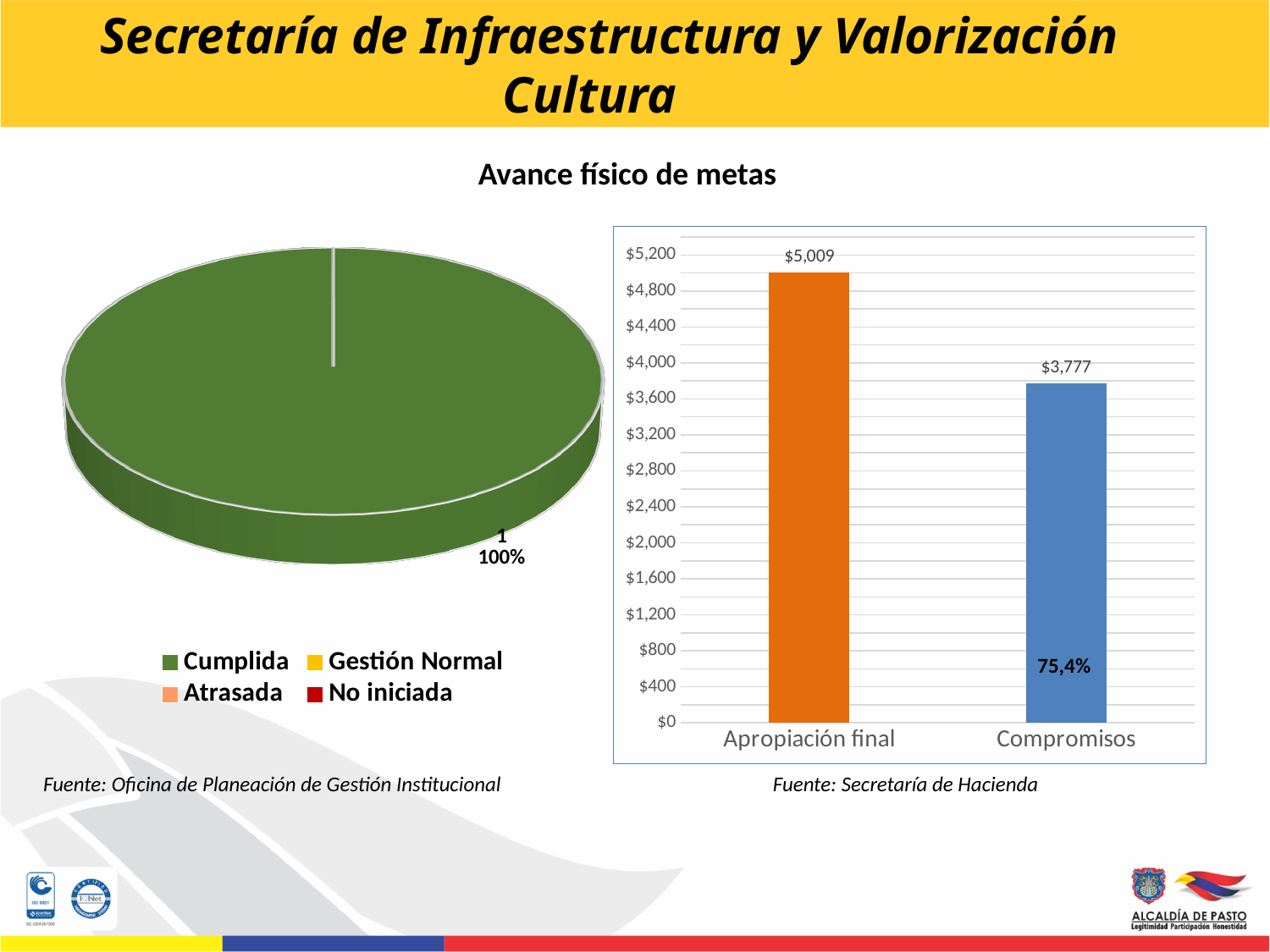
On the bar chart on the right, which category has the higher value? Apropiación final How many entries does the legend of the pie chart on the left list? 4 On the pie chart on the left, what share does the Cumplida slice represent? 100% On the bar chart on the right, which category has the lower value? Compromisos What kind of chart is shown on the right side of the slide? bar chart On the bar chart on the right, how many categories are shown on the x axis? 2 What kind of chart is shown on the left side of the slide? pie chart On the bar chart on the right, what is the value for Compromisos? $3,777 On the bar chart on the right, what percentage label is printed on the Compromisos bar? 75,4% On the bar chart on the right, what is the difference between Apropiación final and Compromisos? $1,232 On the bar chart on the right, is the value for Compromisos greater or less than $4,000? less On the bar chart on the right, what is the value for Apropiación final? $5,009